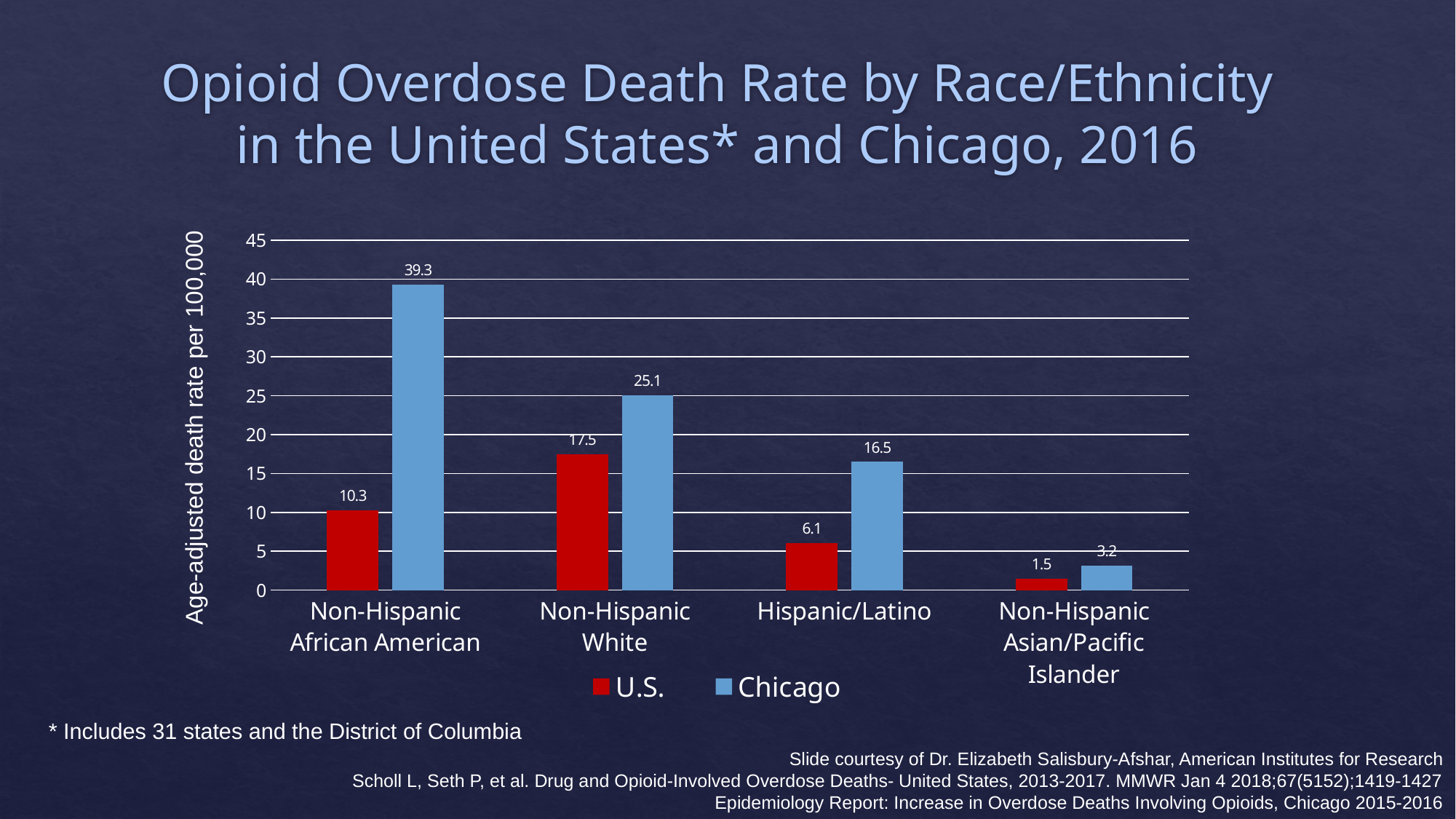
Which race/ethnicity group has the highest Chicago death rate? Non-Hispanic African American What is the difference between the Chicago and U.S. death rates for Hispanic/Latino? 10.4 What is the Chicago opioid overdose death rate for Non-Hispanic African American? 39.3 What is the U.S. opioid overdose death rate for Non-Hispanic White? 17.5 How many series does the legend list? 2 What is the Chicago value for Non-Hispanic Asian/Pacific Islander? 3.2 How many race/ethnicity categories are shown on the x axis? 4 Which is larger, the U.S. rate for Non-Hispanic White or the Chicago rate for Hispanic/Latino? U.S. rate for Non-Hispanic White What is the U.S. value for Hispanic/Latino? 6.1 What kind of chart is shown on the slide? Bar chart What is the difference between the Chicago and U.S. death rates for Non-Hispanic African American? 29 Which race/ethnicity group has the lowest U.S. death rate? Non-Hispanic Asian/Pacific Islander